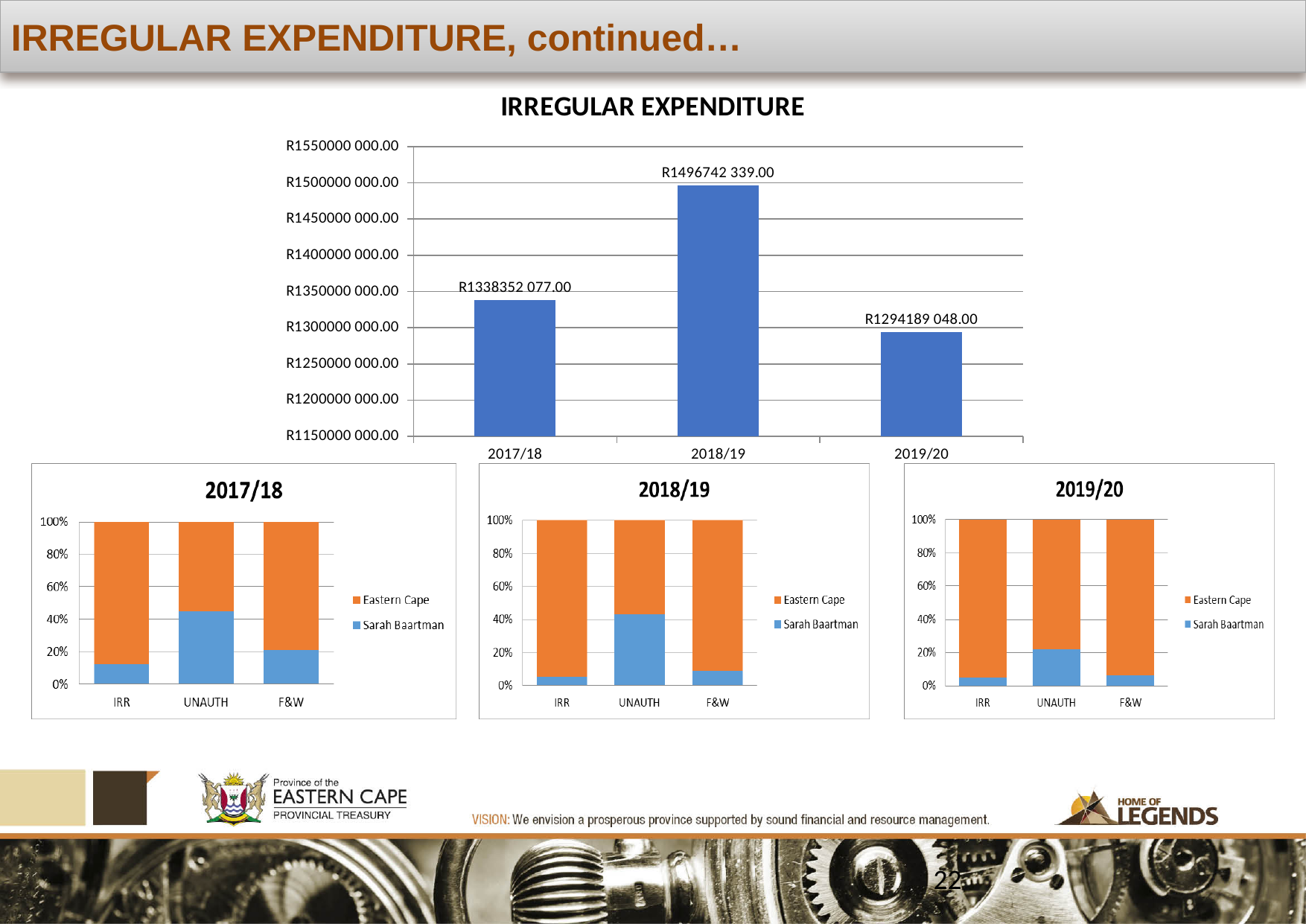
In the IRREGULAR EXPENDITURE bar chart at the top, does the value rise or fall from 2018/19 to 2019/20? fall In the IRREGULAR EXPENDITURE bar chart at the top, what is the value for 2019/20? R1294189 048.00 In the 2017/18 chart at the bottom left, is the Sarah Baartman share for UNAUTH greater or less than 40%? greater In the IRREGULAR EXPENDITURE bar chart at the top, what is the value for 2017/18? R1338352 077.00 In the IRREGULAR EXPENDITURE bar chart at the top, which year has the lowest value? 2019/20 In the IRREGULAR EXPENDITURE bar chart at the top, how many years are shown? 3 In the IRREGULAR EXPENDITURE bar chart at the top, what is the value for 2018/19? R1496742 339.00 In the IRREGULAR EXPENDITURE bar chart at the top, which year has the highest value? 2018/19 In the 2018/19 chart at the bottom centre, how many series does the legend list? 2 In the 2018/19 chart at the bottom centre, which category has the larger Sarah Baartman share, IRR or UNAUTH? UNAUTH In the 2019/20 chart at the bottom right, is the Sarah Baartman share for UNAUTH greater or less than 40%? less What kind of chart is the 2017/18 chart at the bottom left? stacked bar chart